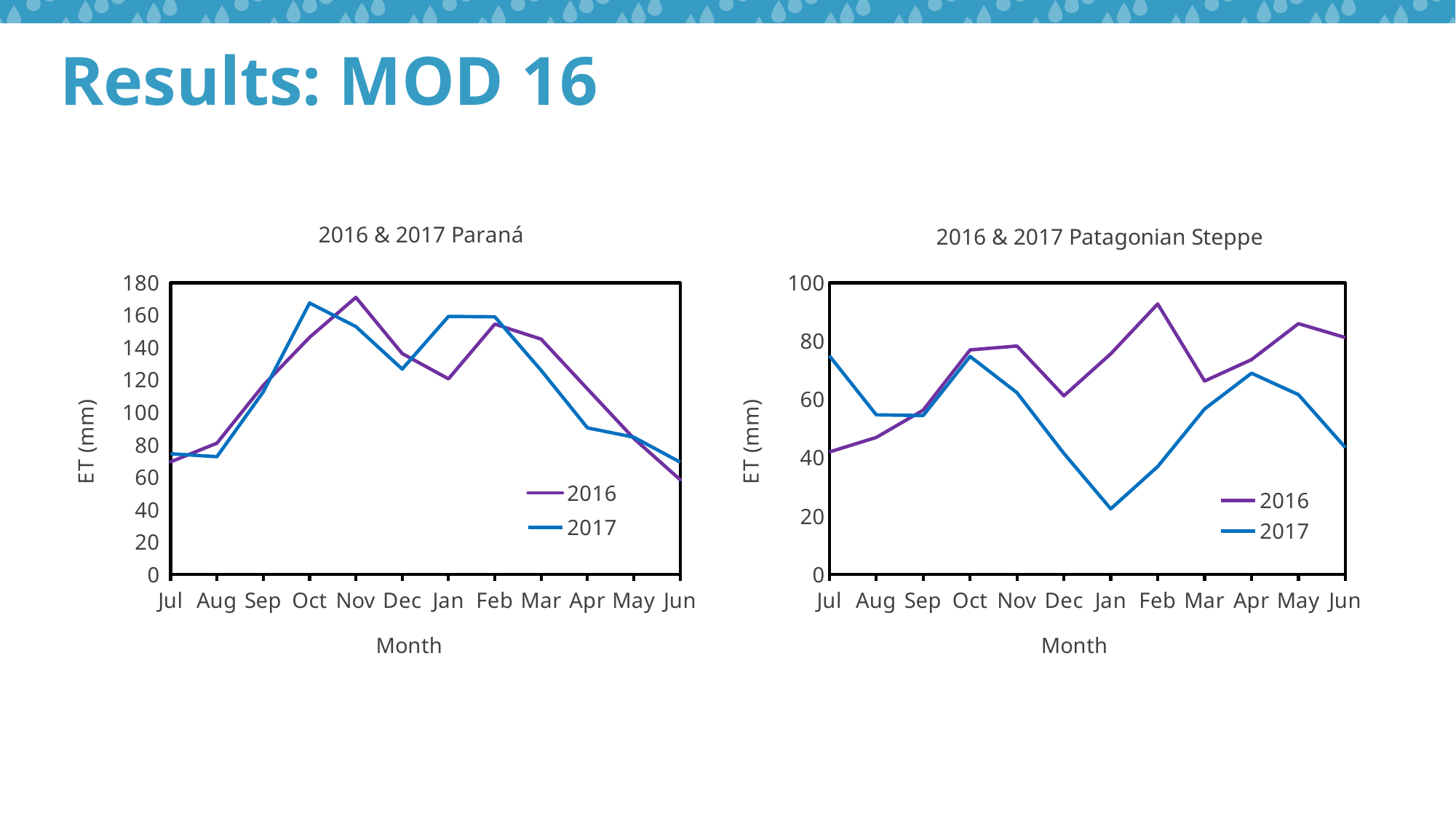
In the '2016 & 2017 Patagonian Steppe' chart, in which month is the 2017 series lowest? Jan In the '2016 & 2017 Paraná' chart, in which month is the 2016 series lowest? Jun In the '2016 & 2017 Paraná' chart, in which month does the 2017 series reach its highest value? Oct What kind of chart is the '2016 & 2017 Paraná' chart? line chart How many months are shown on the x axis of the '2016 & 2017 Paraná' chart? 12 How many series does the legend of the '2016 & 2017 Patagonian Steppe' chart list? 2 In the '2016 & 2017 Paraná' chart, is the 2017 value for Jan greater or less than 140? greater In the '2016 & 2017 Paraná' chart, in which month does the 2016 series reach its highest value? Nov In the '2016 & 2017 Patagonian Steppe' chart, is the 2017 value for Jan greater or less than 40? less In the '2016 & 2017 Patagonian Steppe' chart, in which month does the 2016 series reach its highest value? Feb In the '2016 & 2017 Patagonian Steppe' chart, which series has the larger value in Dec, 2016 or 2017? 2016 In the '2016 & 2017 Paraná' chart, which series has the larger value in Jan, 2016 or 2017? 2017